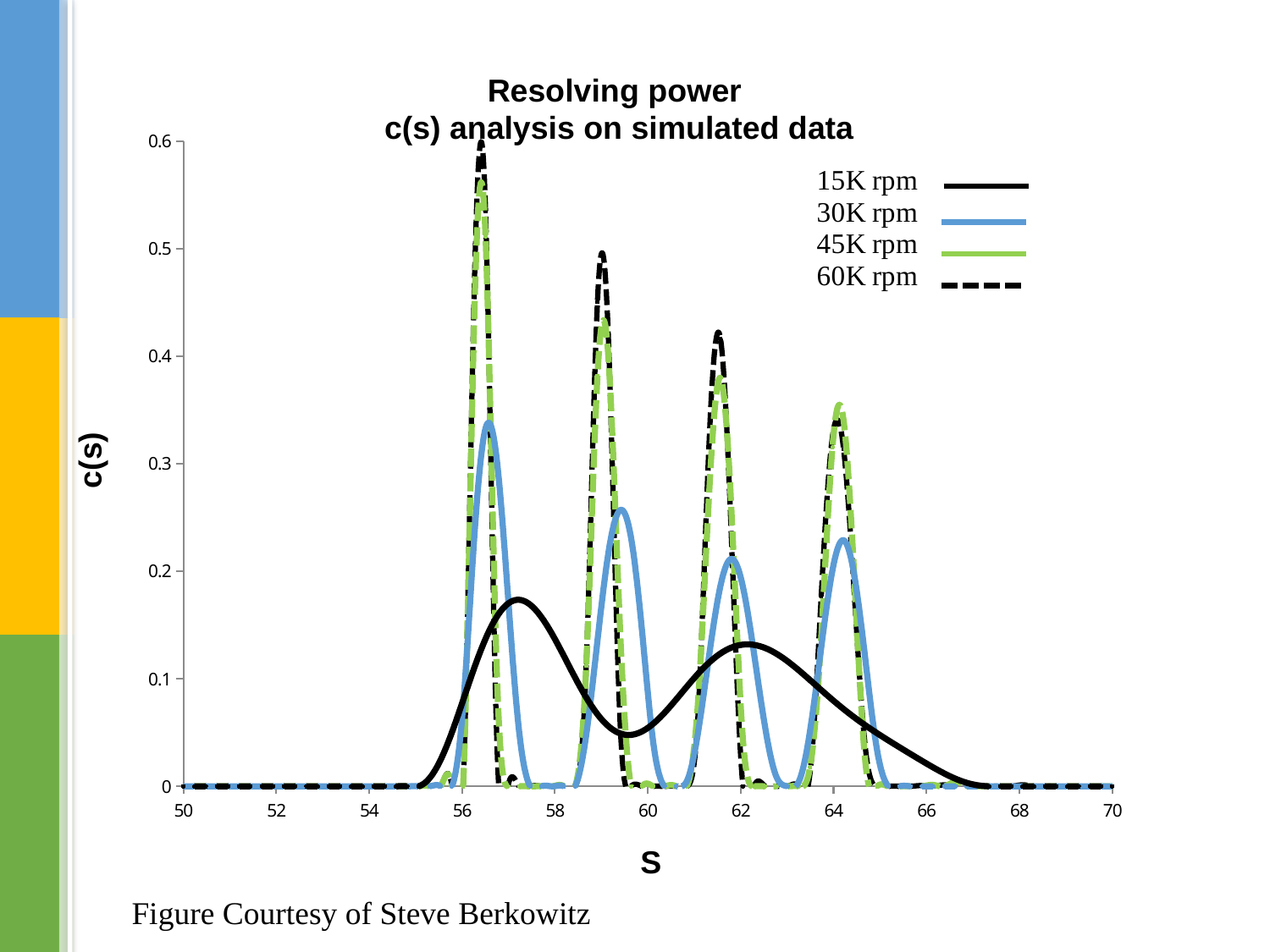
Which series has the lowest maximum value on the chart? 15K rpm Is the highest peak of the 60K rpm series greater or less than 0.5? greater What is the title of the chart? Resolving power c(s) analysis on simulated data How many distinct peaks does the 30K rpm curve show? 4 How many series does the legend list? 4 What kind of chart is shown on the slide? line chart Is the value of the 15K rpm series at s = 60 greater or less than 0.1? less Which series is drawn as a dashed black line? 60K rpm Near s = 59, which series reaches a higher peak, 30K rpm or 60K rpm? 60K rpm How many distinct peaks does the 15K rpm curve show? 2 Is the highest peak of the 30K rpm series greater or less than 0.3? greater